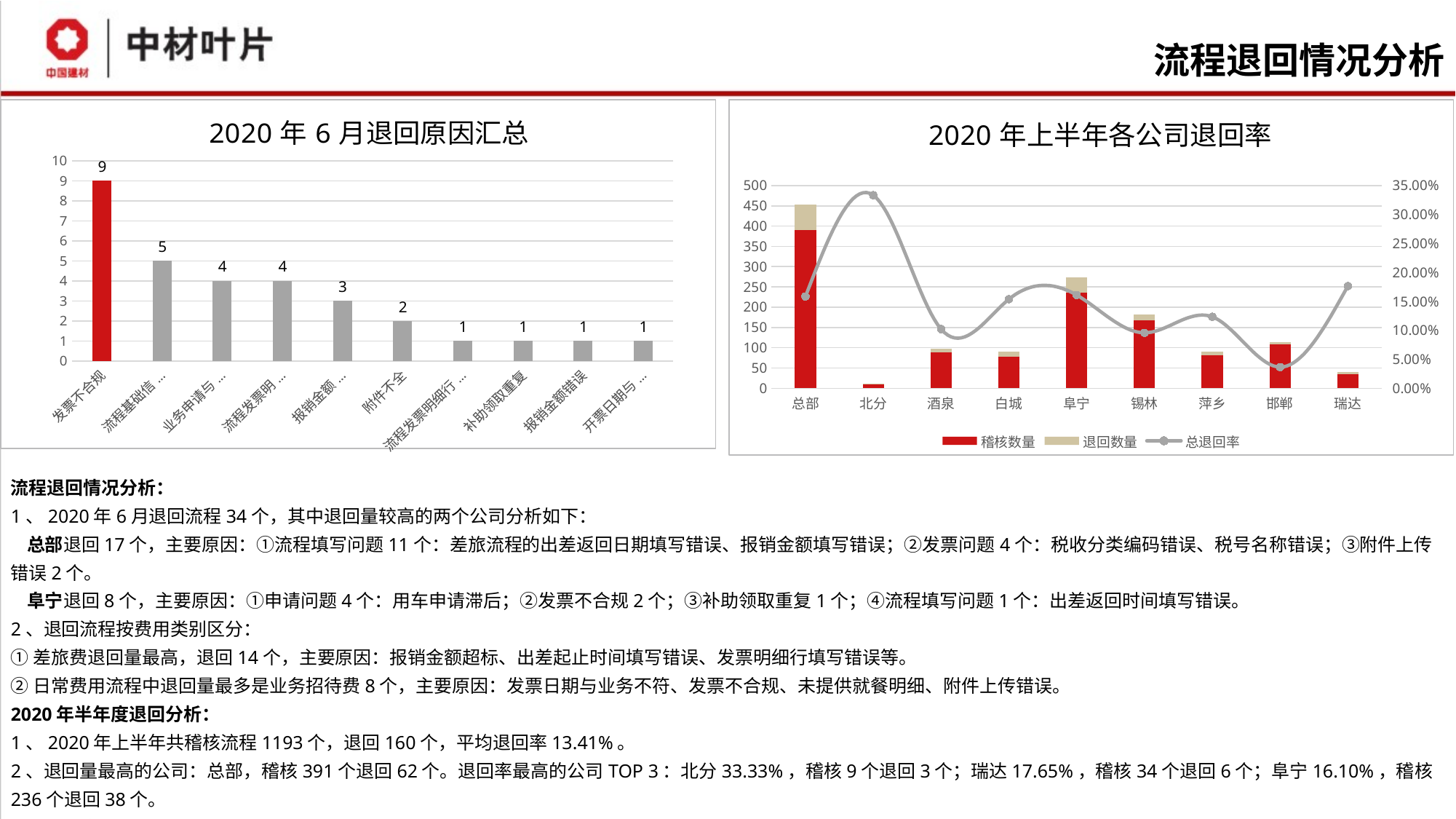
In the right chart (2020年上半年各公司退回率), which company has the highest 总退回率? 北分 How many companies are shown on the x axis of the right chart (2020年上半年各公司退回率)? 9 In the right chart (2020年上半年各公司退回率), is the 总退回率 for 北分 greater or less than 30.00%? greater In the left chart (2020年6月退回原因汇总), what is the difference between the values for 发票不合规 and 附件不全? 7 What kind of chart is the left chart titled 2020年6月退回原因汇总? bar chart How many series does the legend of the right chart (2020年上半年各公司退回率) list? 3 In the right chart (2020年上半年各公司退回率), is the 稽核数量 value for 总部 greater or less than 350? greater How many categories are shown in the left chart (2020年6月退回原因汇总)? 10 In the left chart (2020年6月退回原因汇总), what is the value for 附件不全? 2 In the left chart (2020年6月退回原因汇总), which category has the highest value? 发票不合规 In the left chart (2020年6月退回原因汇总), which is larger: the value for 附件不全 or for 补助领取重复? 附件不全 In the left chart (2020年6月退回原因汇总), what is the value for 发票不合规? 9